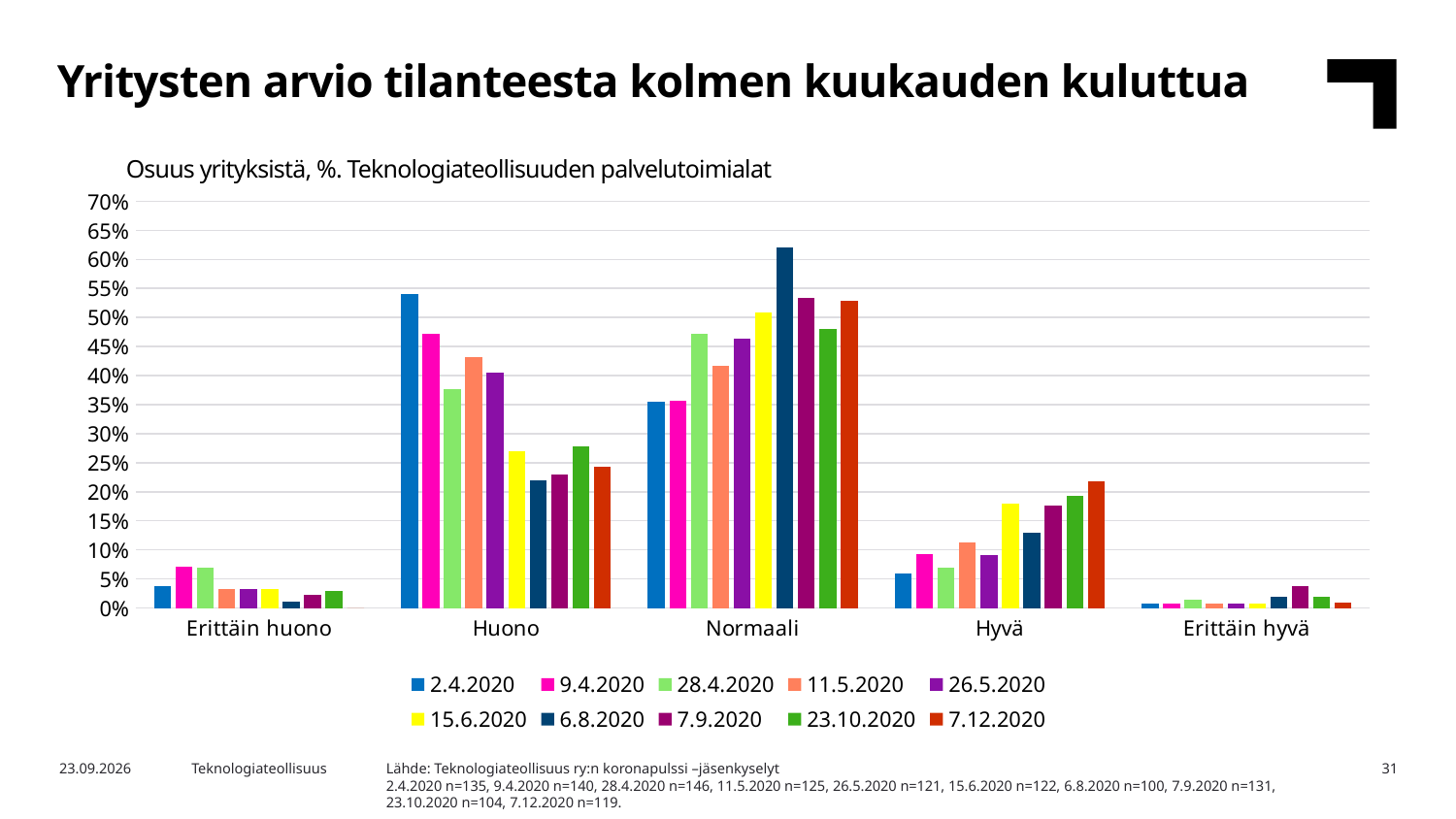
What kind of chart is shown on the slide? Bar chart Is the value for 7.12.2020 in the Hyvä category greater or less than 15%? greater Which series has the highest bar in the Hyvä category? 7.12.2020 How many series does the legend list? 10 In which category is the 6.8.2020 bar the highest? Normaali Is the value for 6.8.2020 in the Normaali category greater or less than 60%? greater In the Huono category, which is larger: the 2.4.2020 bar or the 9.4.2020 bar? 2.4.2020 What is the subtitle text shown above the chart? Osuus yrityksistä, %. Teknologiateollisuuden palvelutoimialat Is the value for 2.4.2020 in the Huono category greater or less than 50%? greater In the Normaali category, which is larger: the 15.6.2020 bar or the 26.5.2020 bar? 15.6.2020 How many categories are shown on the x axis? 5